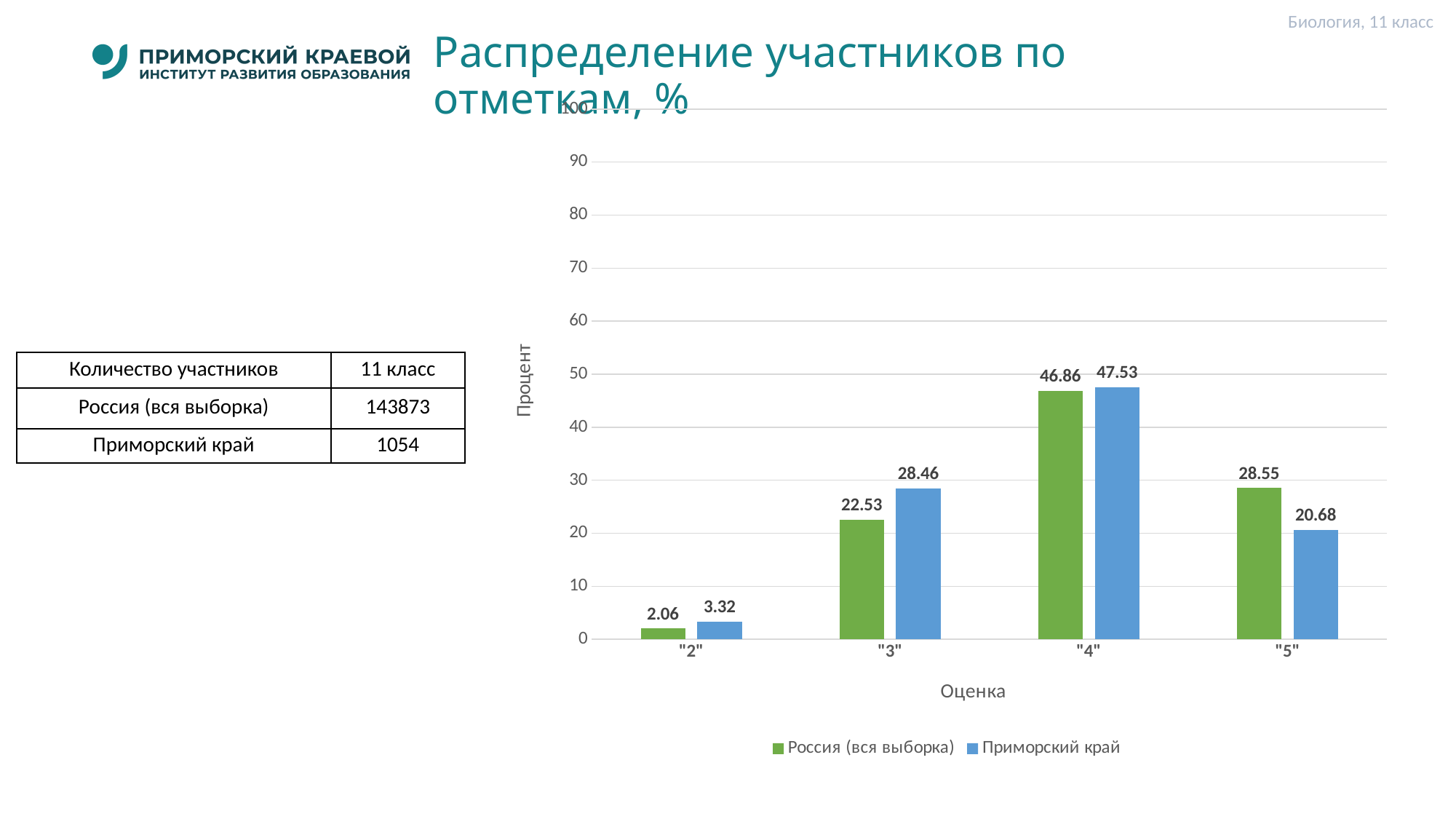
What is the value for Приморский край for grade "5"? 20.68 How many grade categories are shown on the x axis of the chart? 4 How many series does the chart legend list? 2 For grade "3", which series has the larger value, Россия (вся выборка) or Приморский край? Приморский край Is the value for Россия (вся выборка) for grade "5" greater or less than 30? less What is the value for Приморский край for grade "3"? 28.46 Which grade has the highest value for Приморский край? "4" What is the label of the y axis of the chart? Процент What is the value for Россия (вся выборка) for grade "4"? 46.86 What type of chart is shown on the slide? bar chart What is the difference between Россия (вся выборка) and Приморский край for grade "5"? 7.87 Which grade has the lowest value for Россия (вся выборка)? "2"